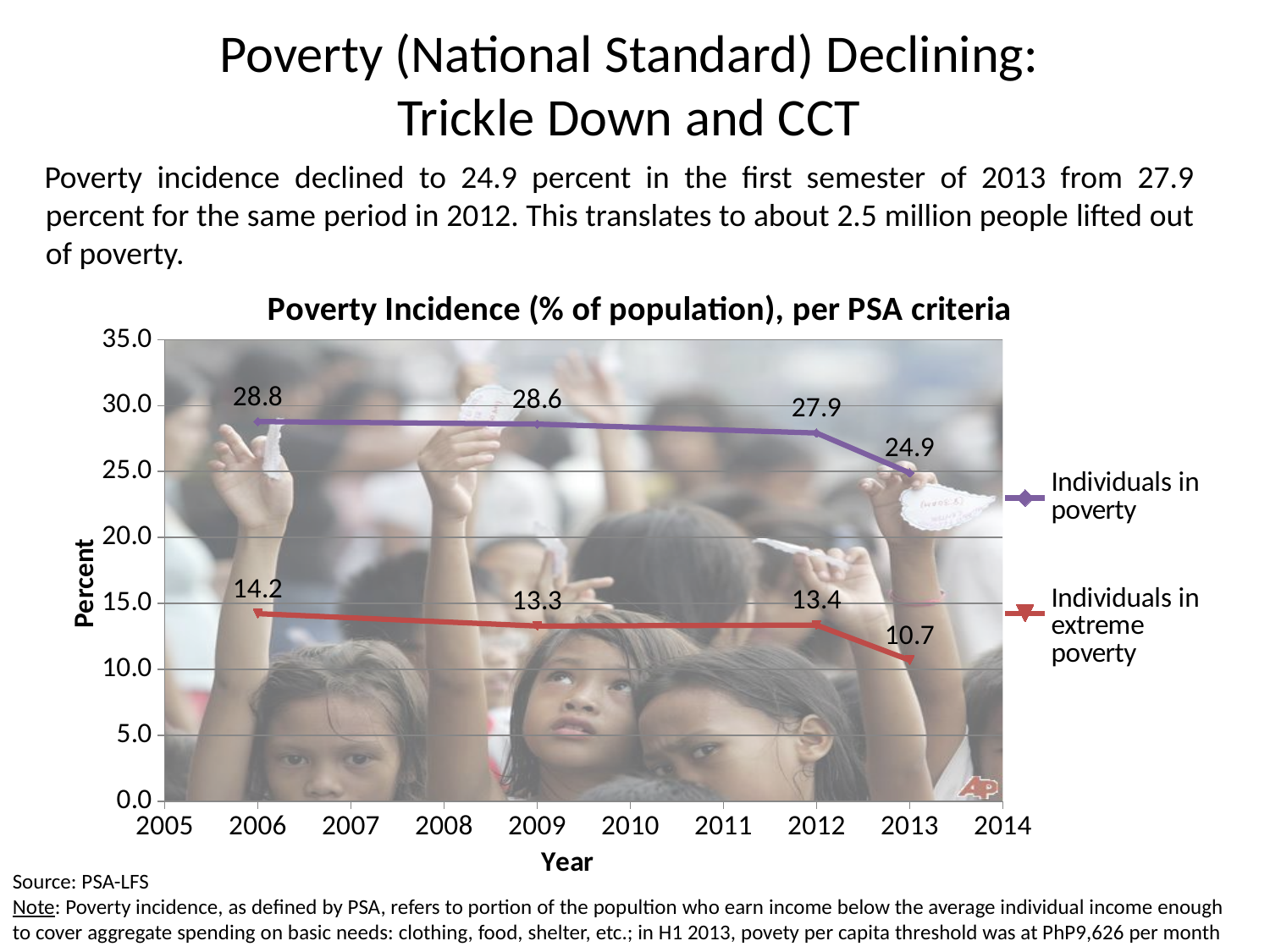
What is the difference between Individuals in poverty and Individuals in extreme poverty in 2013? 14.2 What is the value for Individuals in poverty in 2012? 27.9 In which year is the value for Individuals in poverty lowest? 2013 By how much did the value for Individuals in poverty fall from 2012 to 2013? 3.0 What kind of chart is shown? Line chart Which is larger: Individuals in extreme poverty in 2009 or in 2012? 2012 Do the values for Individuals in poverty rise or fall from 2006 to 2013? Fall Is the value for Individuals in poverty in 2013 greater or less than 25.0? less How many series does the legend list? 2 What is the value for Individuals in poverty in 2006? 28.8 In which year is the value for Individuals in extreme poverty highest? 2006 What is the value for Individuals in extreme poverty in 2013? 10.7